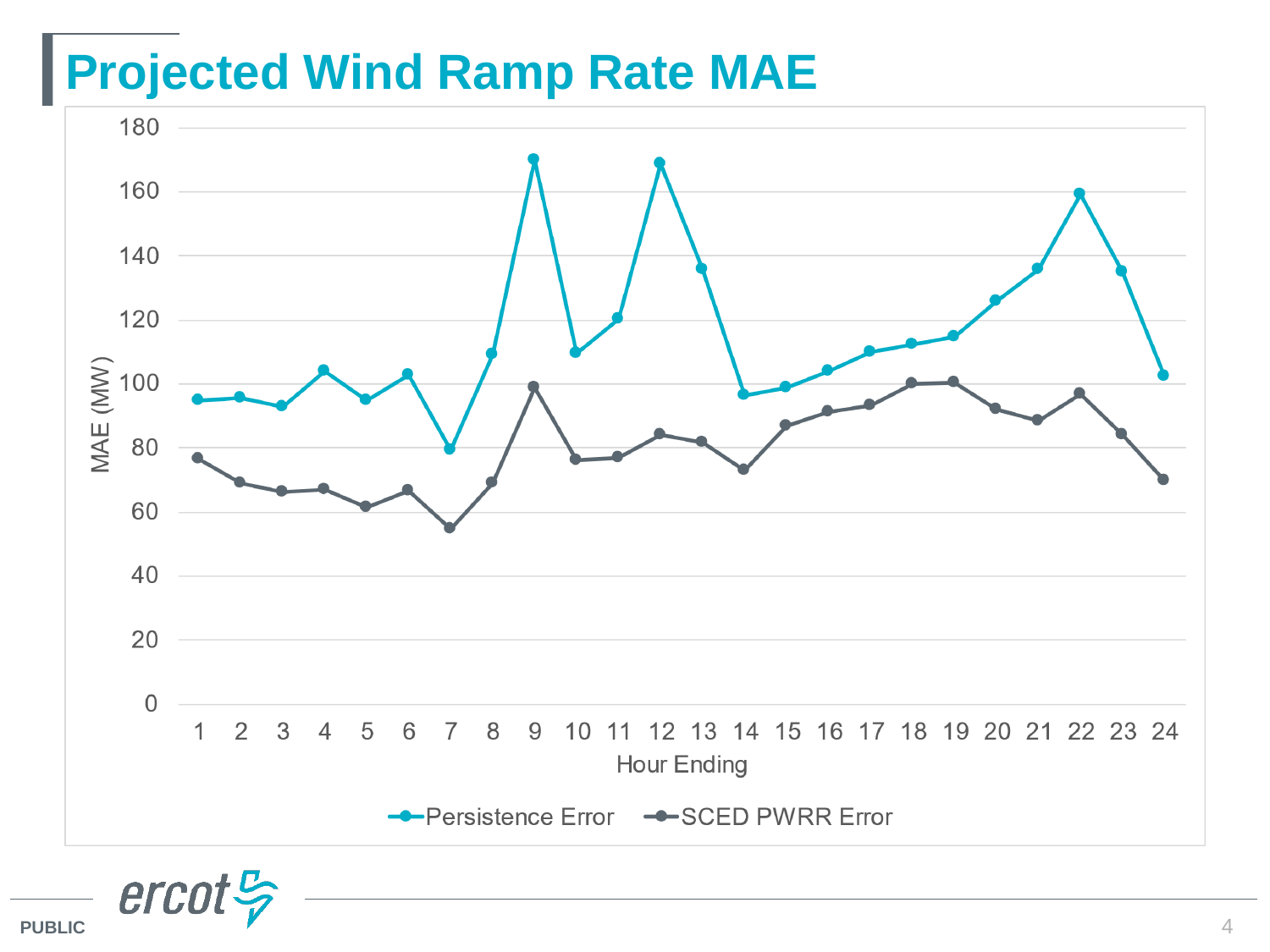
For the Persistence Error series, which is larger: the value at hour ending 4 or at hour ending 7? hour ending 4 What is the title of the y axis? MAE (MW) Is the Persistence Error at hour ending 22 greater or less than 140? greater At which hour ending is the SCED PWRR Error lowest? 7 Is the Persistence Error at hour ending 9 greater or less than 160? greater Does the Persistence Error rise or fall from hour ending 14 to hour ending 22? rise How many hours are plotted along the x axis? 24 Which series has the larger value at hour ending 12, Persistence Error or SCED PWRR Error? Persistence Error Is the SCED PWRR Error at hour ending 7 greater or less than 60? less How many series does the legend list? 2 What kind of chart is shown on the slide? line chart At which hour ending is the Persistence Error lowest? 7